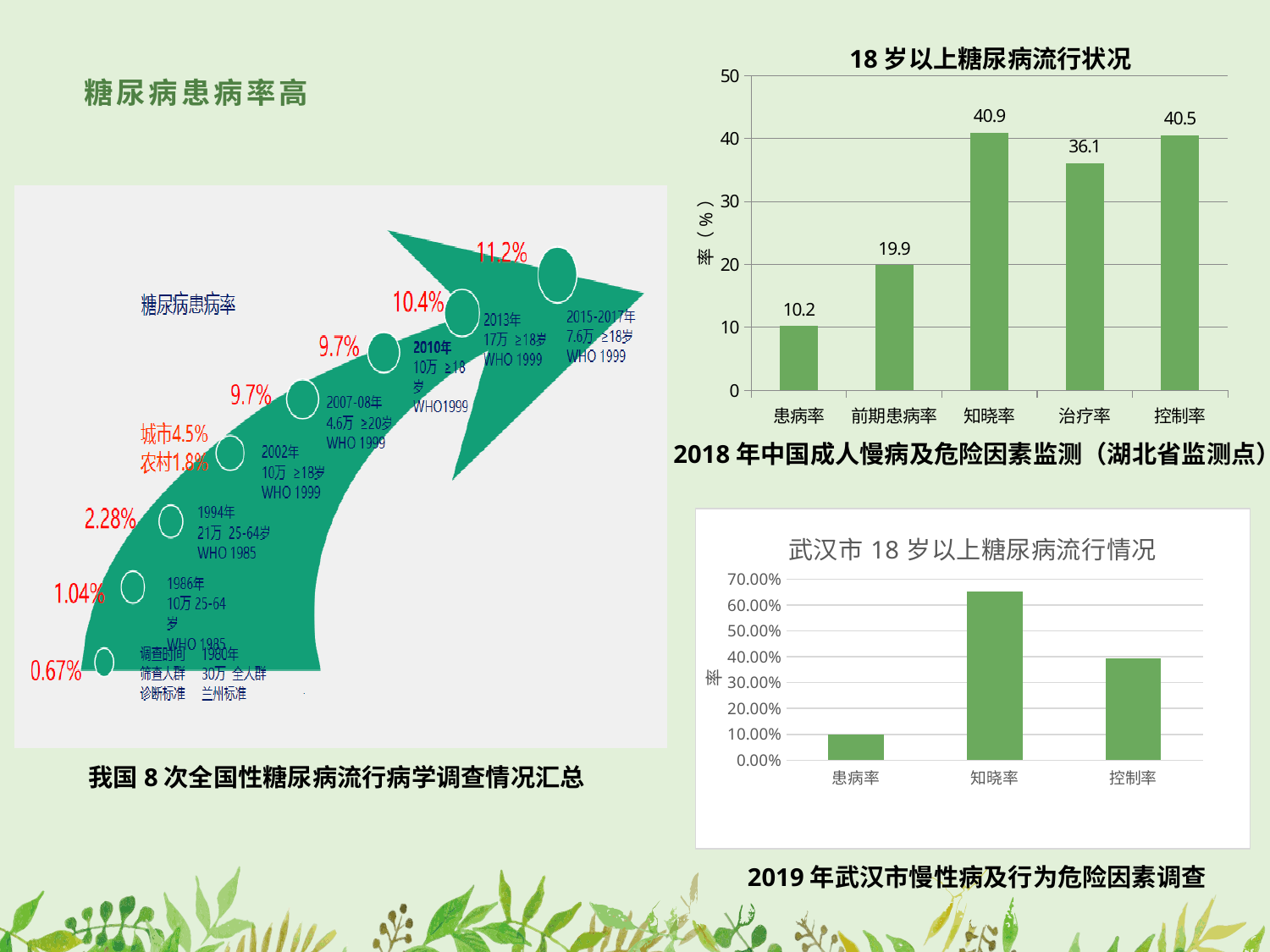
In the chart titled 18 岁以上糖尿病流行状况, which category has the highest value? 知晓率 In the chart titled 18 岁以上糖尿病流行状况, what is the difference between 知晓率 and 患病率? 30.7 In the chart titled 武汉市 18 岁以上糖尿病流行情况, is the value for 知晓率 greater or less than 60.00%? greater In the chart titled 武汉市 18 岁以上糖尿病流行情况, how many categories are shown on the x axis? 3 In the chart titled 18 岁以上糖尿病流行状况, what is the value for 治疗率? 36.1 What kind of chart is the chart titled 18 岁以上糖尿病流行状况? Bar chart In the chart titled 武汉市 18 岁以上糖尿病流行情况, which category has the highest value? 知晓率 In the chart titled 18 岁以上糖尿病流行状况, which category has the lowest value? 患病率 In the chart titled 18 岁以上糖尿病流行状况, what is the value for 知晓率? 40.9 In the chart titled 18 岁以上糖尿病流行状况, which is larger, 治疗率 or 控制率? 控制率 In the chart titled 武汉市 18 岁以上糖尿病流行情况, is the value for 控制率 greater or less than 30.00%? greater In the chart titled 18 岁以上糖尿病流行状况, how many categories are shown on the x axis? 5